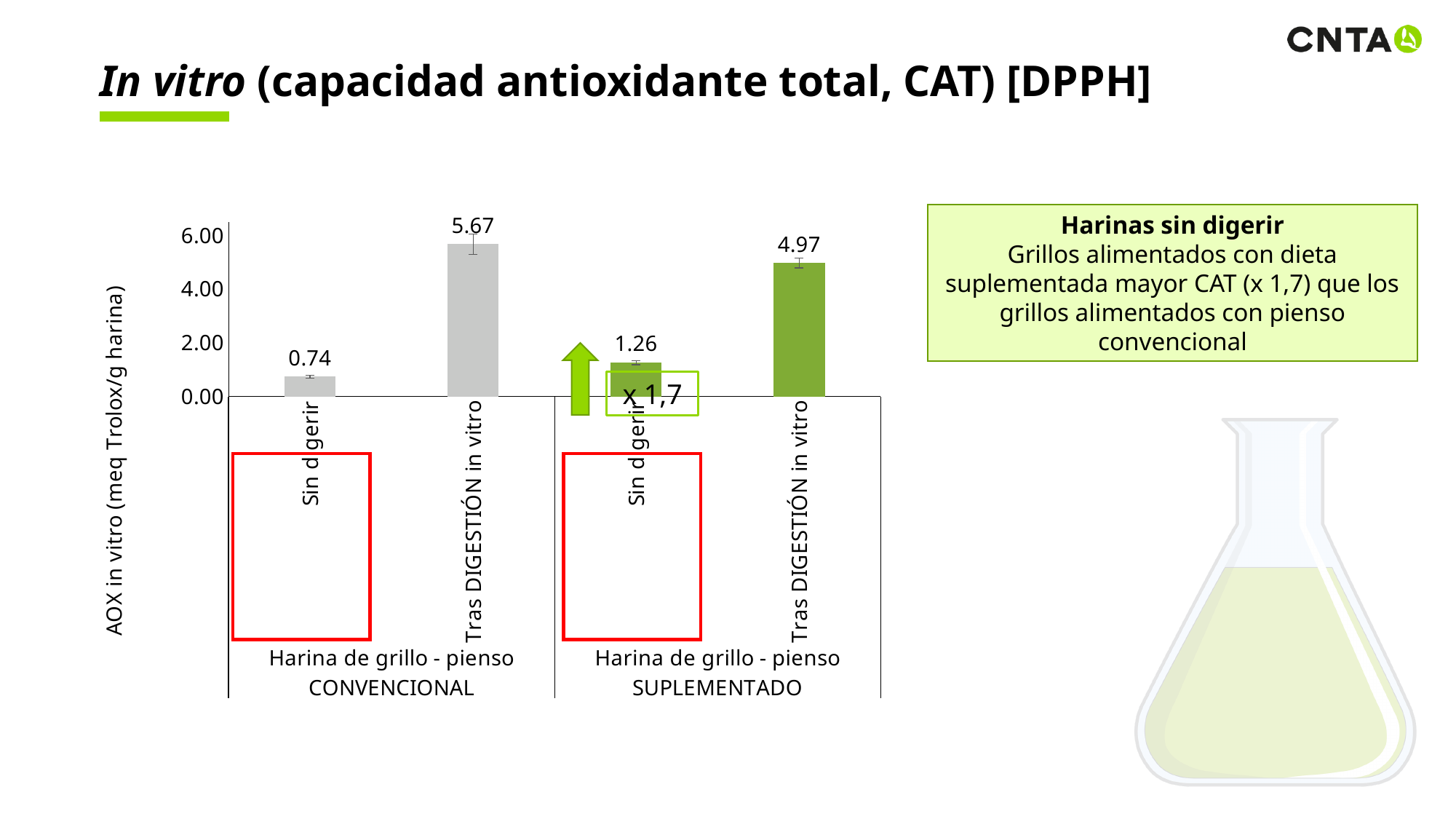
What is the value for 'Tras DIGESTIÓN in vitro' in the 'Harina de grillo - pienso SUPLEMENTADO' group? 4.97 What is the label of the vertical axis of the chart? AOX in vitro (meq Trolox/g harina) Which is larger: 'Sin digerir' in the CONVENCIONAL group or 'Sin digerir' in the SUPLEMENTADO group? Sin digerir in the SUPLEMENTADO group What is the difference between the 'Tras DIGESTIÓN in vitro' values of the CONVENCIONAL and SUPLEMENTADO groups? 0.70 What type of chart is shown on the slide? bar chart What is the value for 'Sin digerir' in the 'Harina de grillo - pienso SUPLEMENTADO' group? 1.26 How many bars are plotted in the chart? 4 Which bar has the highest value in the chart? Tras DIGESTIÓN in vitro (Harina de grillo - pienso CONVENCIONAL) What is the difference between the 'Sin digerir' values of the SUPLEMENTADO and CONVENCIONAL groups? 0.52 What is the value for 'Sin digerir' in the 'Harina de grillo - pienso CONVENCIONAL' group? 0.74 What is the value for 'Tras DIGESTIÓN in vitro' in the 'Harina de grillo - pienso CONVENCIONAL' group? 5.67 Which bar has the lowest value in the chart? Sin digerir (Harina de grillo - pienso CONVENCIONAL)